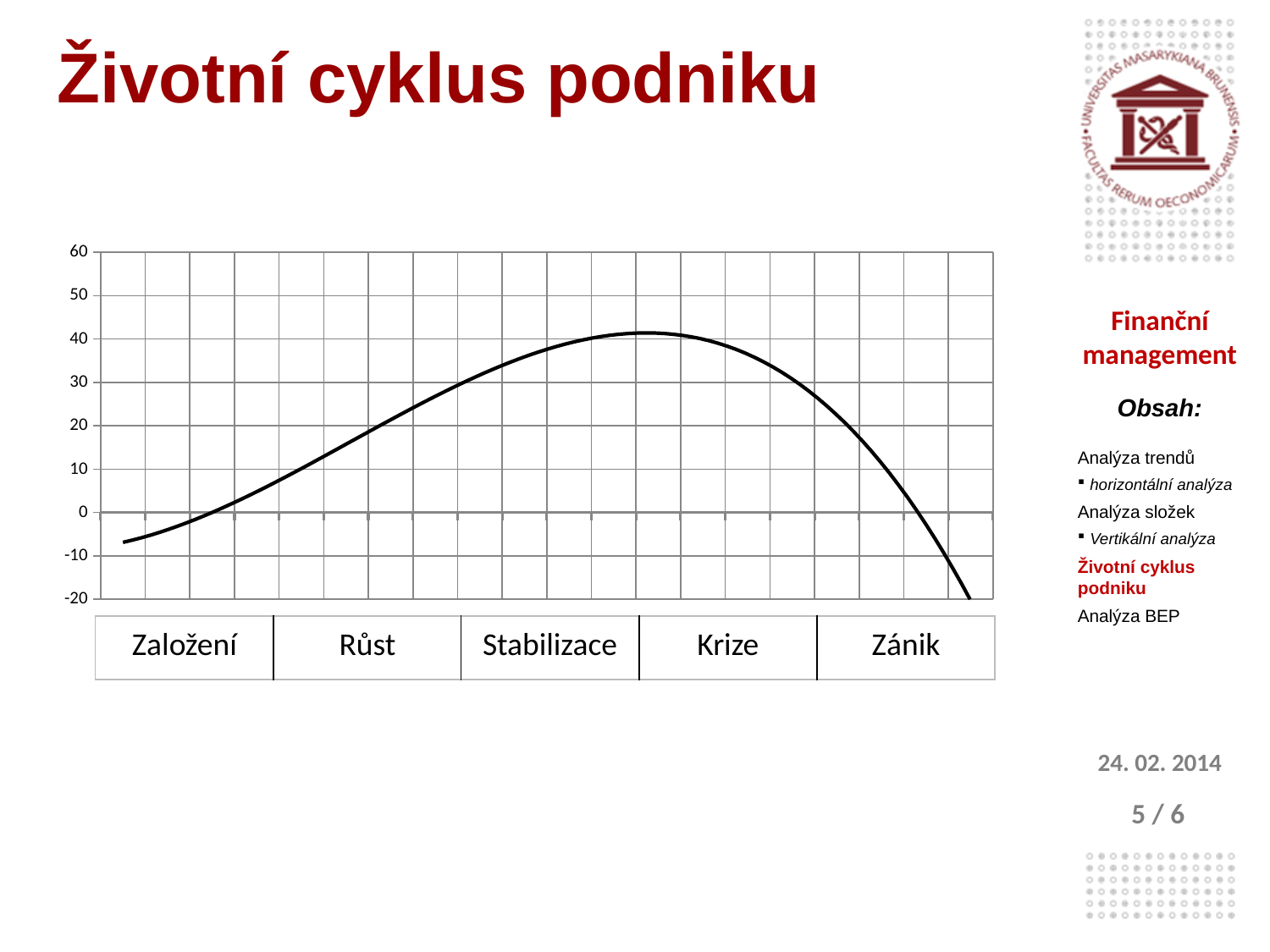
Is the peak value of the curve greater or less than 50? less How many phases are labelled along the x axis of the chart? 5 Does the curve rise or fall during the Růst phase? rises Does the curve rise or fall during the Krize phase? falls Is the peak value of the curve greater or less than 30? greater What is the title of the slide containing the chart? Životní cyklus podniku What kind of chart is shown on the slide? line chart Which phase is labelled first on the x axis of the chart? Založení Is the value of the curve at the start of the Založení phase greater or less than 0? less In which phase does the curve reach its lowest point? Zánik